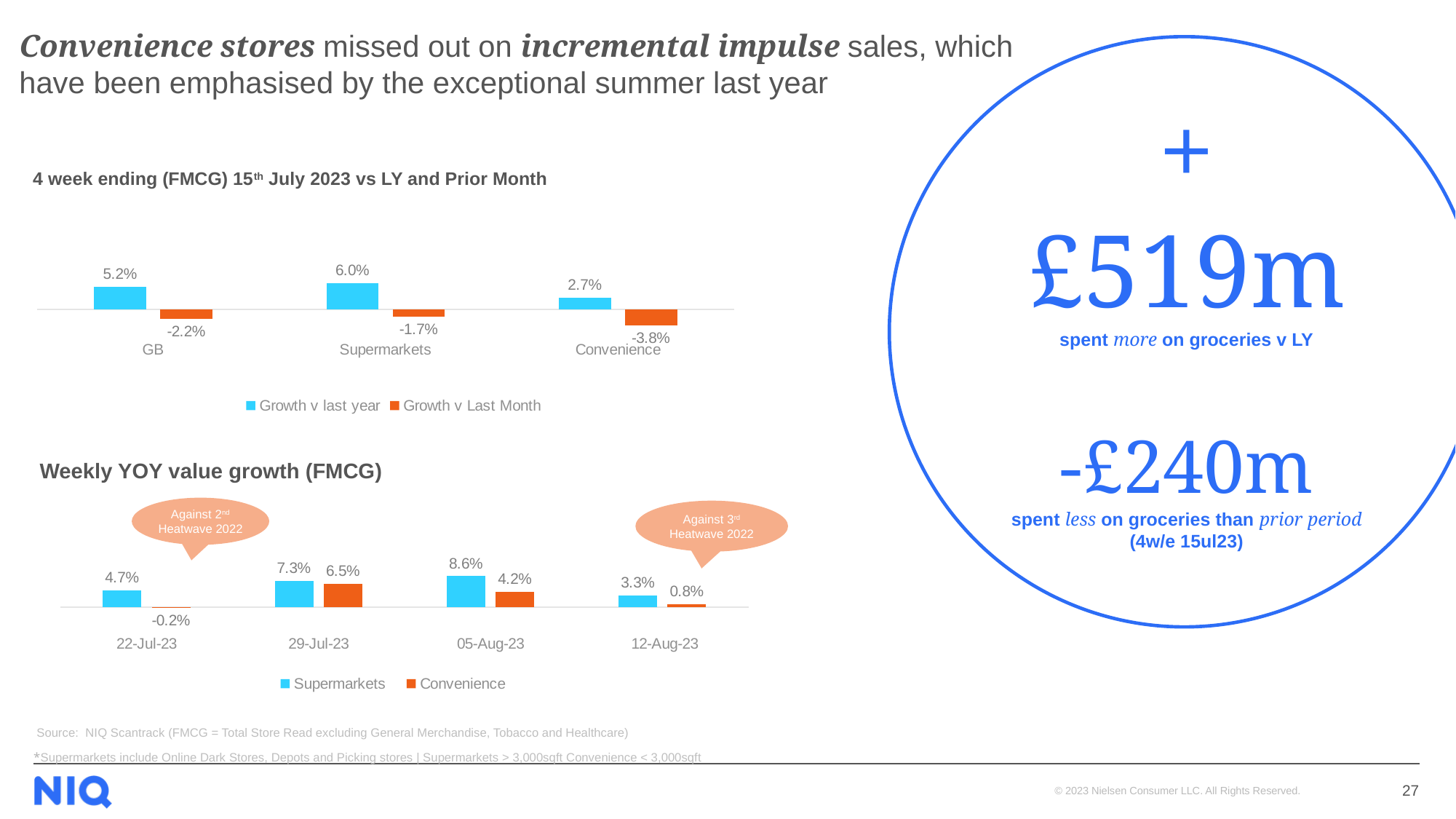
In the 'Weekly YOY value growth (FMCG)' chart, how many weeks are shown on the x axis? 4 In the 'Weekly YOY value growth (FMCG)' chart, which week has the highest Convenience value? 29-Jul-23 In the 'Weekly YOY value growth (FMCG)' chart, which is larger for 12-Aug-23: Supermarkets or Convenience? Supermarkets In the '4 week ending (FMCG) 15th July 2023 vs LY and Prior Month' chart, what is the difference between the Growth v last year values for Supermarkets and Convenience? 3.3 percentage points In the 'Weekly YOY value growth (FMCG)' chart, what is the Convenience value for 22-Jul-23? -0.2% In the '4 week ending (FMCG) 15th July 2023 vs LY and Prior Month' chart, what is the Growth v last year value for Supermarkets? 6.0% In the '4 week ending (FMCG) 15th July 2023 vs LY and Prior Month' chart, which category has the lowest Growth v last year? Convenience What kind of chart is the 'Weekly YOY value growth (FMCG)' chart? Bar chart In the '4 week ending (FMCG) 15th July 2023 vs LY and Prior Month' chart, how many series does the legend list? 2 In the '4 week ending (FMCG) 15th July 2023 vs LY and Prior Month' chart, what is the Growth v Last Month value for Convenience? -3.8% In the 'Weekly YOY value growth (FMCG)' chart, what is the Supermarkets value for 05-Aug-23? 8.6% In the 'Weekly YOY value growth (FMCG)' chart, what is the difference between the Supermarkets and Convenience values for 05-Aug-23? 4.4 percentage points